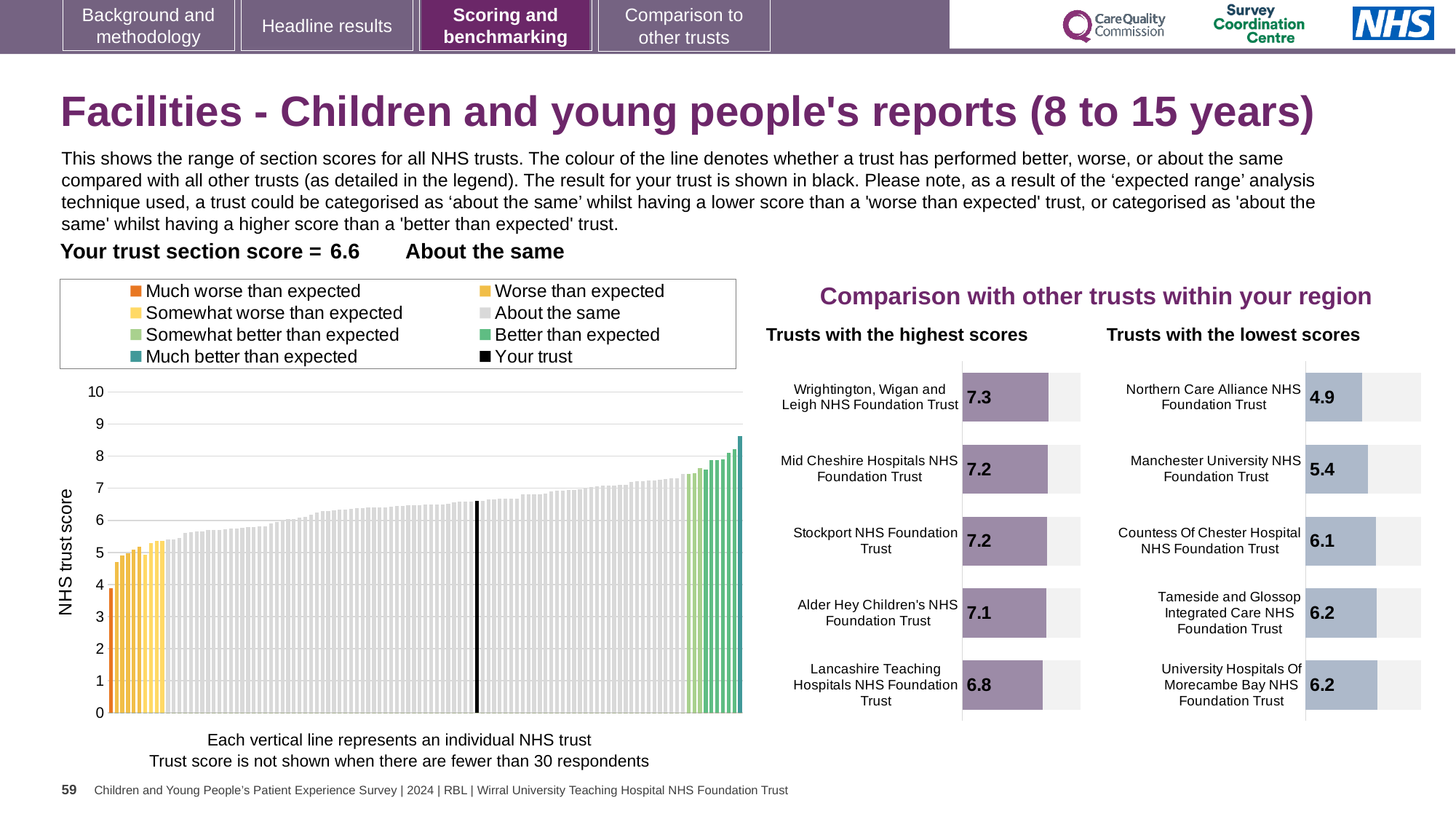
In the 'Trusts with the highest scores' chart, which trust has the lowest score? Lancashire Teaching Hospitals NHS Foundation Trust In the 'Trusts with the lowest scores' chart, which has the higher score: Manchester University NHS Foundation Trust or Countess Of Chester Hospital NHS Foundation Trust? Countess Of Chester Hospital NHS Foundation Trust In the 'Trusts with the lowest scores' chart, what is the difference between the scores of Manchester University NHS Foundation Trust and Northern Care Alliance NHS Foundation Trust? 0.5 In the 'Trusts with the lowest scores' chart, which trust has the highest score? Tameside and Glossop Integrated Care NHS Foundation Trust and University Hospitals Of Morecambe Bay NHS Foundation Trust (both 6.2) In the large chart on the left, do the trust scores rise or fall from left to right? Rise How many entries does the legend of the large chart on the left list? 8 In the large chart on the left, is the value of the black bar (your trust) greater or less than 6? greater In the 'Trusts with the highest scores' chart, what is the difference between the scores of Wrightington, Wigan and Leigh NHS Foundation Trust and Lancashire Teaching Hospitals NHS Foundation Trust? 0.5 In the 'Trusts with the lowest scores' chart, what is the score for Northern Care Alliance NHS Foundation Trust? 4.9 In the 'Trusts with the highest scores' chart, what is the score for Wrightington, Wigan and Leigh NHS Foundation Trust? 7.3 In the 'Trusts with the highest scores' chart, how many trusts are shown? 5 What kind of chart is the large chart on the left showing NHS trust scores? Bar chart